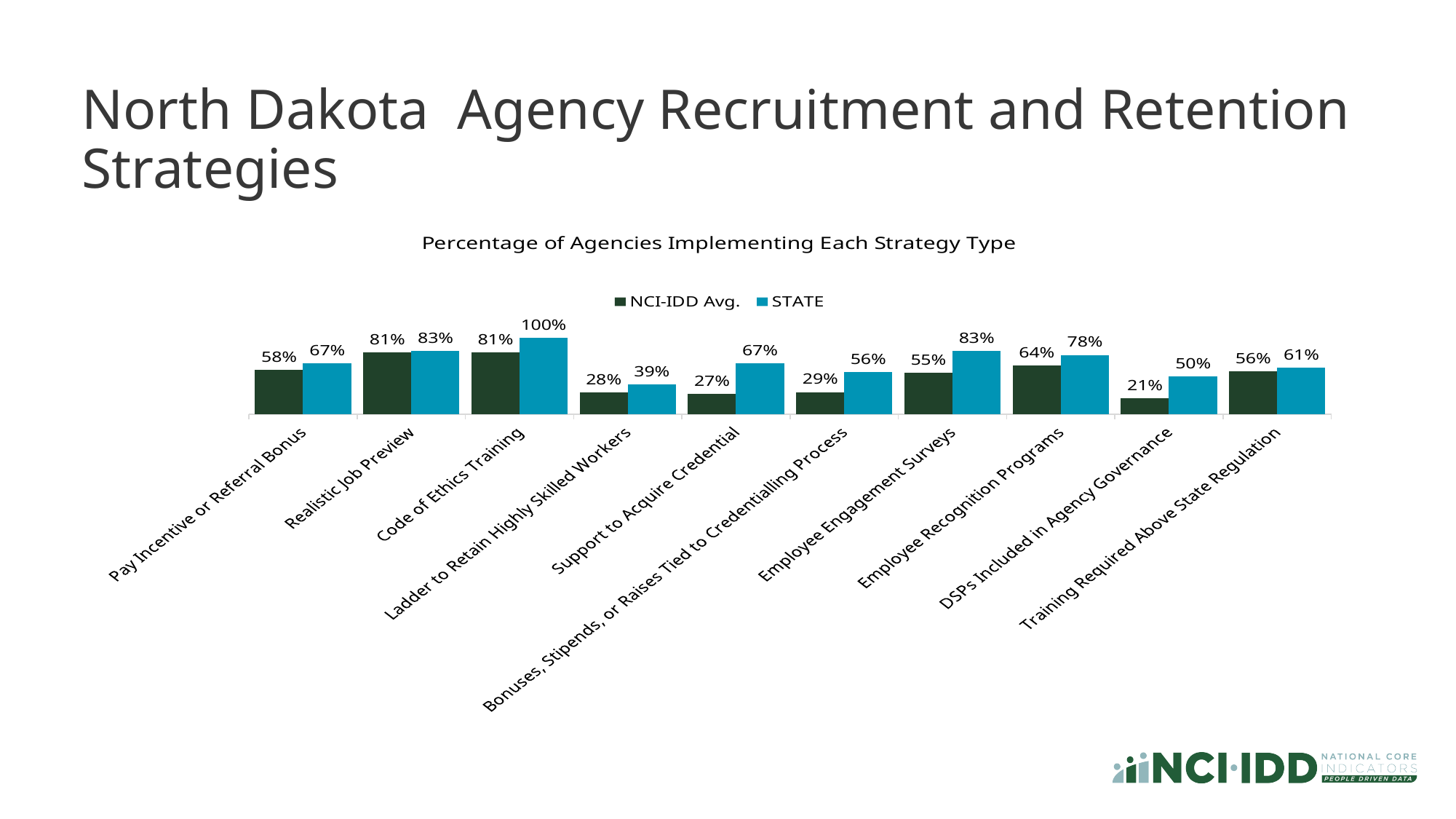
What is the STATE value for Employee Recognition Programs? 78% For Employee Engagement Surveys, which is larger: the NCI-IDD Avg. value or the STATE value? STATE How many series does the legend list? 2 What is the title of the chart? Percentage of Agencies Implementing Each Strategy Type What is the NCI-IDD Avg. value for DSPs Included in Agency Governance? 21% How many strategy categories are shown on the x axis? 10 Which category has the highest STATE value? Code of Ethics Training What kind of chart is shown on the slide? Bar chart What is the difference between the STATE and NCI-IDD Avg. values for Support to Acquire Credential? 40% What is the STATE value for Code of Ethics Training? 100% What is the NCI-IDD Avg. value for Bonuses, Stipends, or Raises Tied to Credentialling Process? 29% Which category has the lowest NCI-IDD Avg. value? DSPs Included in Agency Governance